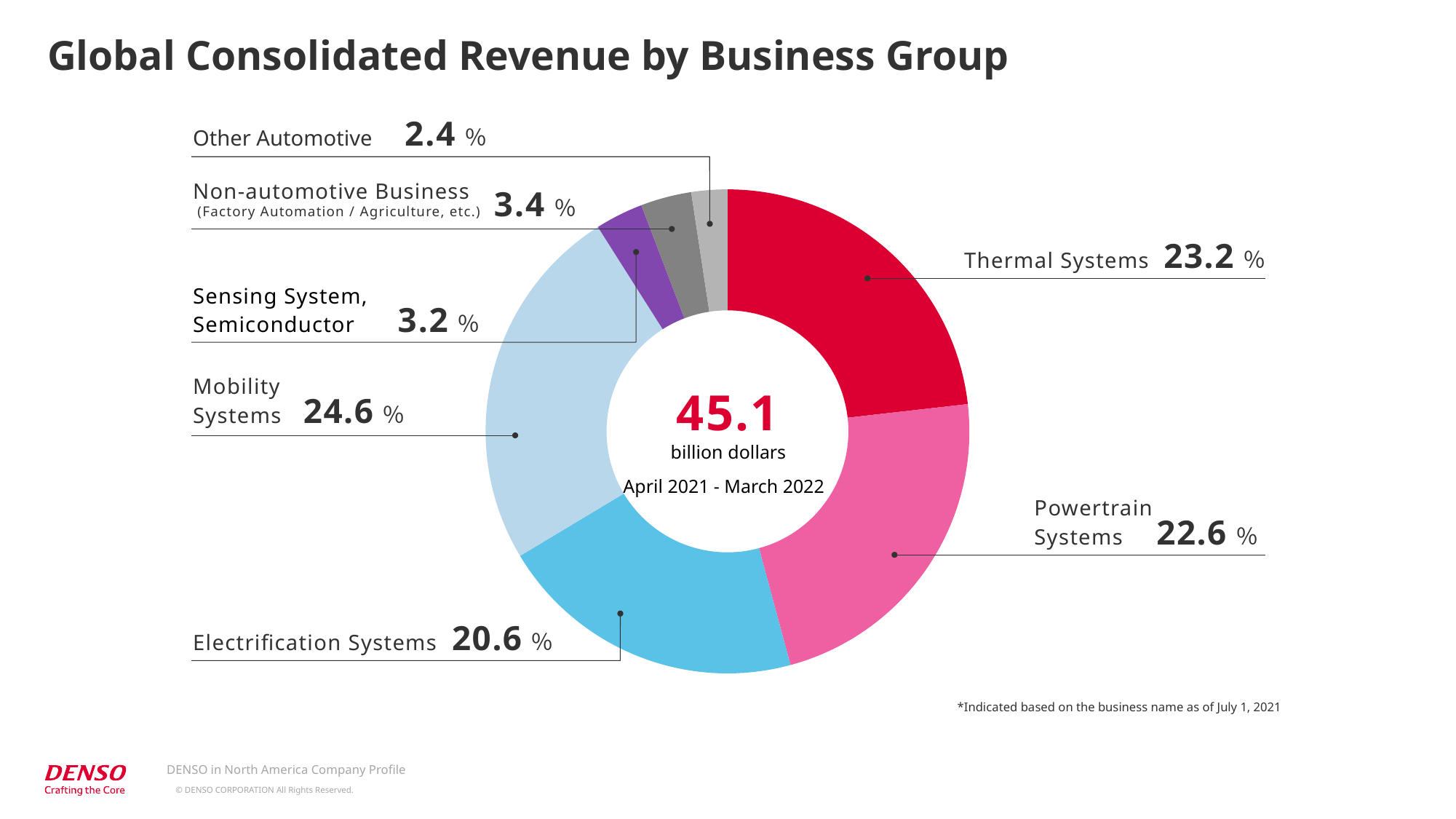
What share of global consolidated revenue comes from Non-automotive Business? 3.4% Which has a larger share of revenue, Non-automotive Business or Sensing System, Semiconductor? Non-automotive Business How many business groups are shown in the chart? 7 What is the difference in percentage points between the Mobility Systems share and the Powertrain Systems share? 2.0 What kind of chart is used to show revenue by business group? Pie chart (donut) Which has a larger share of revenue, Thermal Systems or Electrification Systems? Thermal Systems What total revenue figure is shown in the centre of the chart? 45.1 billion dollars What share of global consolidated revenue comes from Electrification Systems? 20.6% Which business group has the smallest share of global consolidated revenue? Other Automotive What share of global consolidated revenue comes from Thermal Systems? 23.2% What period does the chart cover? April 2021 - March 2022 Which business group has the largest share of global consolidated revenue? Mobility Systems